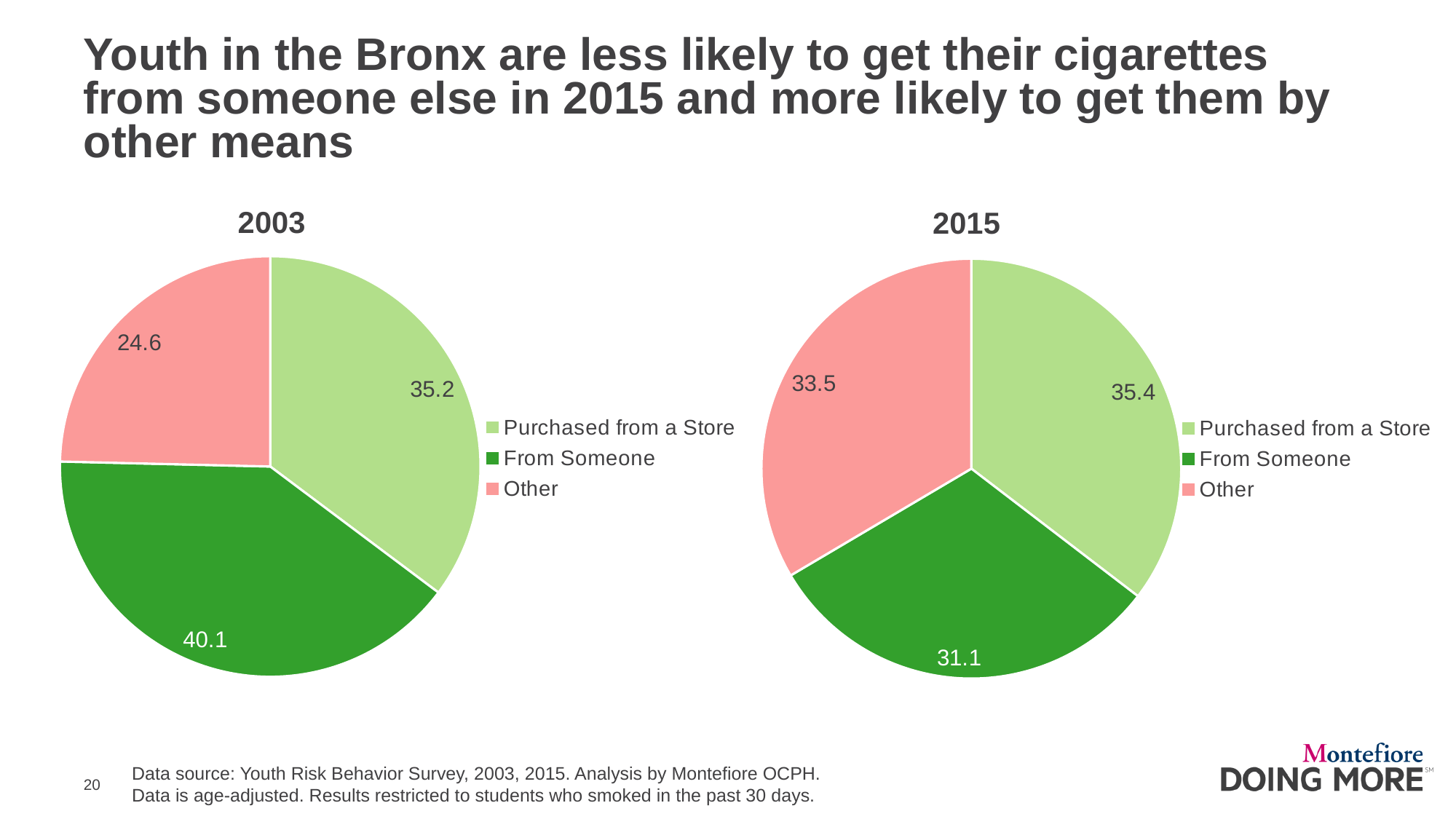
In the 2003 pie chart, what is the difference between the From Someone value and the Other value? 15.5 What is the difference between the From Someone value in the 2003 pie chart and the From Someone value in the 2015 pie chart? 9.0 What type of chart is used for the 2003 data? Pie chart In the 2003 pie chart, which category has the smallest slice? Other In the 2015 pie chart, which category has the smallest slice? From Someone In the 2003 pie chart, what is the value for Purchased from a Store? 35.2 In the 2015 pie chart, what is the value for From Someone? 31.1 How many slices does the 2015 pie chart have? 3 In the 2003 pie chart, what is the value for From Someone? 40.1 In the 2003 pie chart, which category has the largest slice? From Someone In the 2015 pie chart, what is the value for Other? 33.5 In the 2015 pie chart, which category has the largest slice? Purchased from a Store